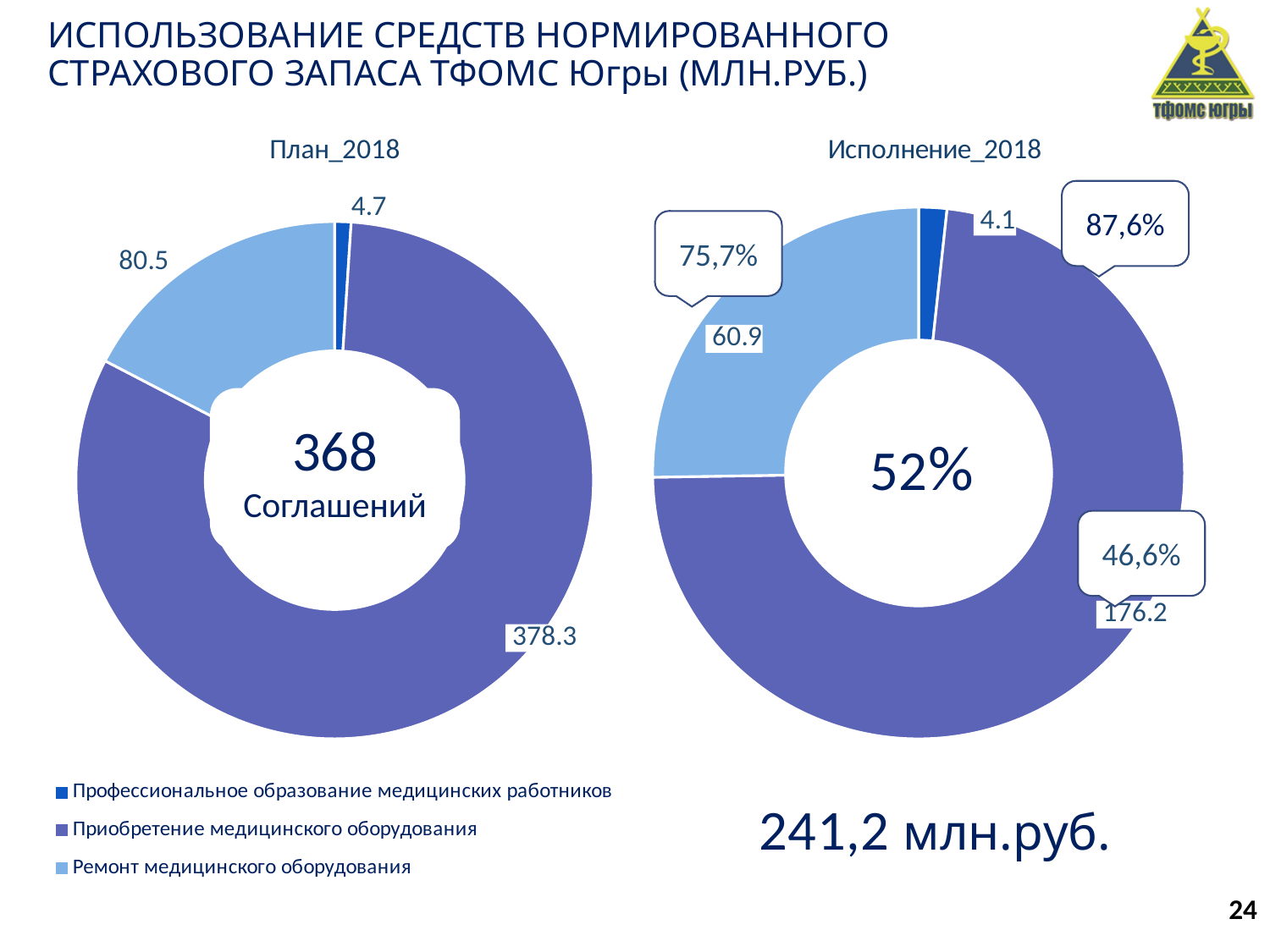
In the Исполнение_2018 chart, which category has the smallest slice? Профессиональное образование медицинских работников In the Исполнение_2018 chart, what is the value for Профессиональное образование медицинских работников? 4.1 In the Исполнение_2018 chart, what is the value for Приобретение медицинского оборудования? 176.2 What type of chart is used for План_2018 and Исполнение_2018? Pie (donut) chart In the План_2018 chart, what is the value for Ремонт медицинского оборудования? 80.5 In the План_2018 chart, which category has the largest slice? Приобретение медицинского оборудования Which is larger: the План_2018 value for Приобретение медицинского оборудования or the Исполнение_2018 value for the same category? План_2018 In the План_2018 chart, what is the value for Профессиональное образование медицинских работников? 4.7 In the План_2018 chart, what is the value for Приобретение медицинского оборудования? 378.3 In the Исполнение_2018 chart, what is the value for Ремонт медицинского оборудования? 60.9 How many categories does the legend list for the charts? 3 What is the difference between the План_2018 and Исполнение_2018 values for Ремонт медицинского оборудования? 19.6